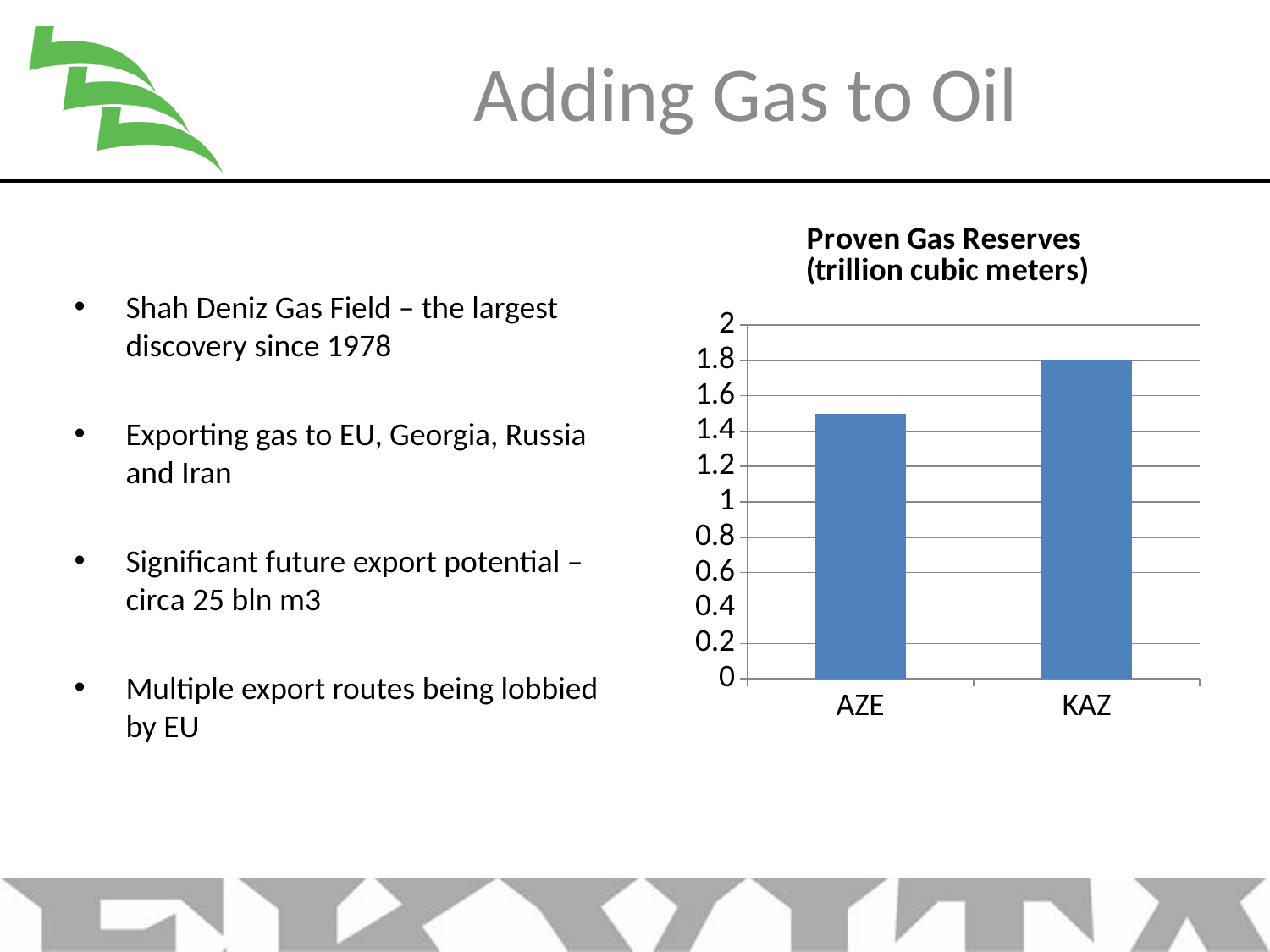
What is the title of the chart? Proven Gas Reserves (trillion cubic meters) Is the value for KAZ greater or less than 1.6? greater Which category has the highest proven gas reserves? KAZ Is the value for AZE greater or less than 1.4? greater Is the value for KAZ greater or less than 2? less What is the value for KAZ in the chart? 1.8 Which category has the lowest proven gas reserves? AZE How many categories are shown on the x axis of the chart? 2 Which is larger, the value for AZE or the value for KAZ? KAZ What is the maximum value shown on the y axis of the chart? 2 What kind of chart is shown on the slide? bar chart